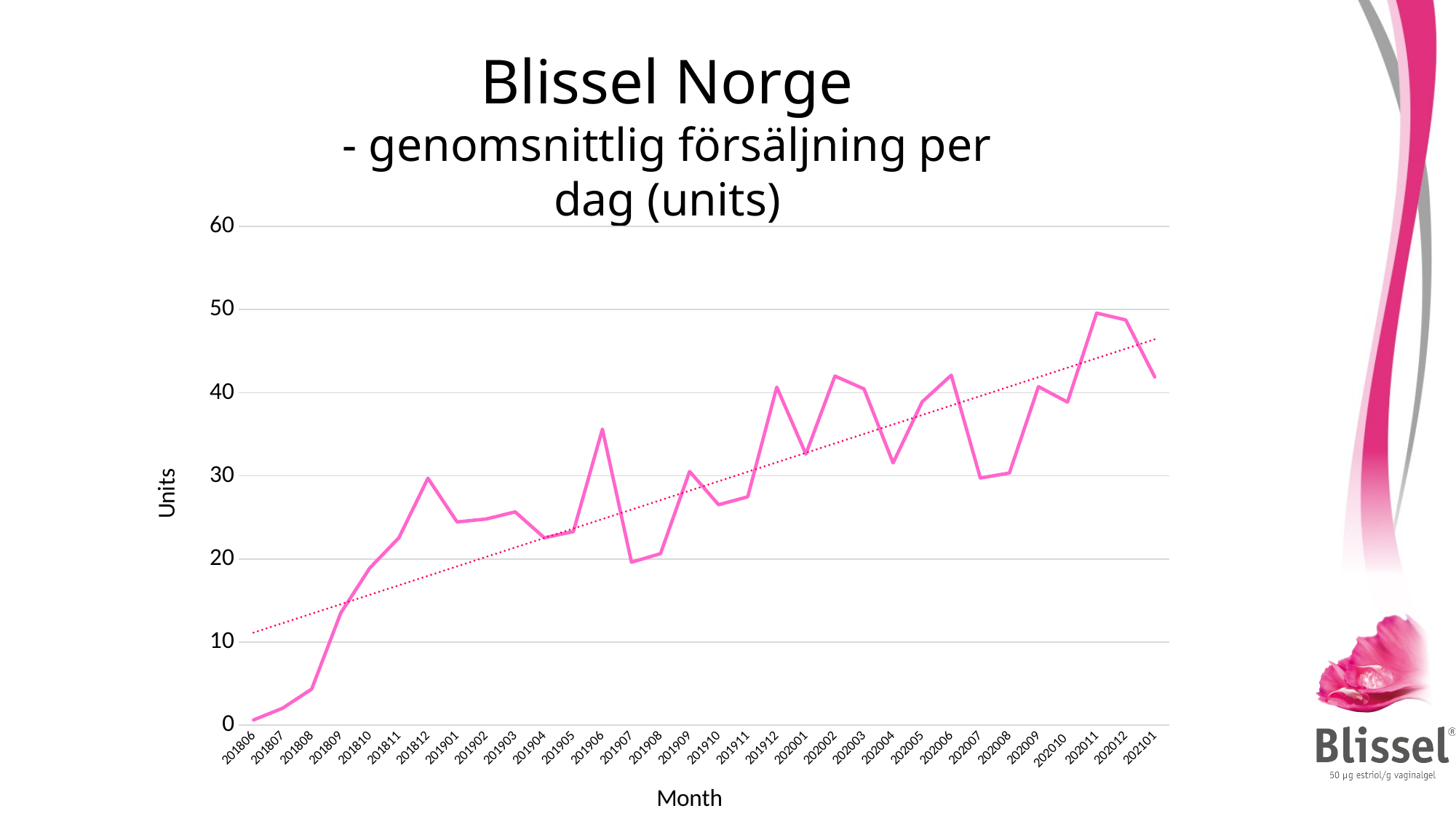
How many monthly data points are plotted on the x axis? 32 Is the value for 202007 greater or less than 40? less Is the value for 201907 greater or less than 30? less Is the value for 201812 greater or less than 20? greater What is the label of the horizontal axis? Month Which is larger, the value for 201906 or the value for 201907? 201906 Which month has the lowest value on the chart? 201806 What kind of chart is shown on the slide? line chart What is the label of the vertical axis? Units Do the values generally rise or fall from 201806 to 202101? rise